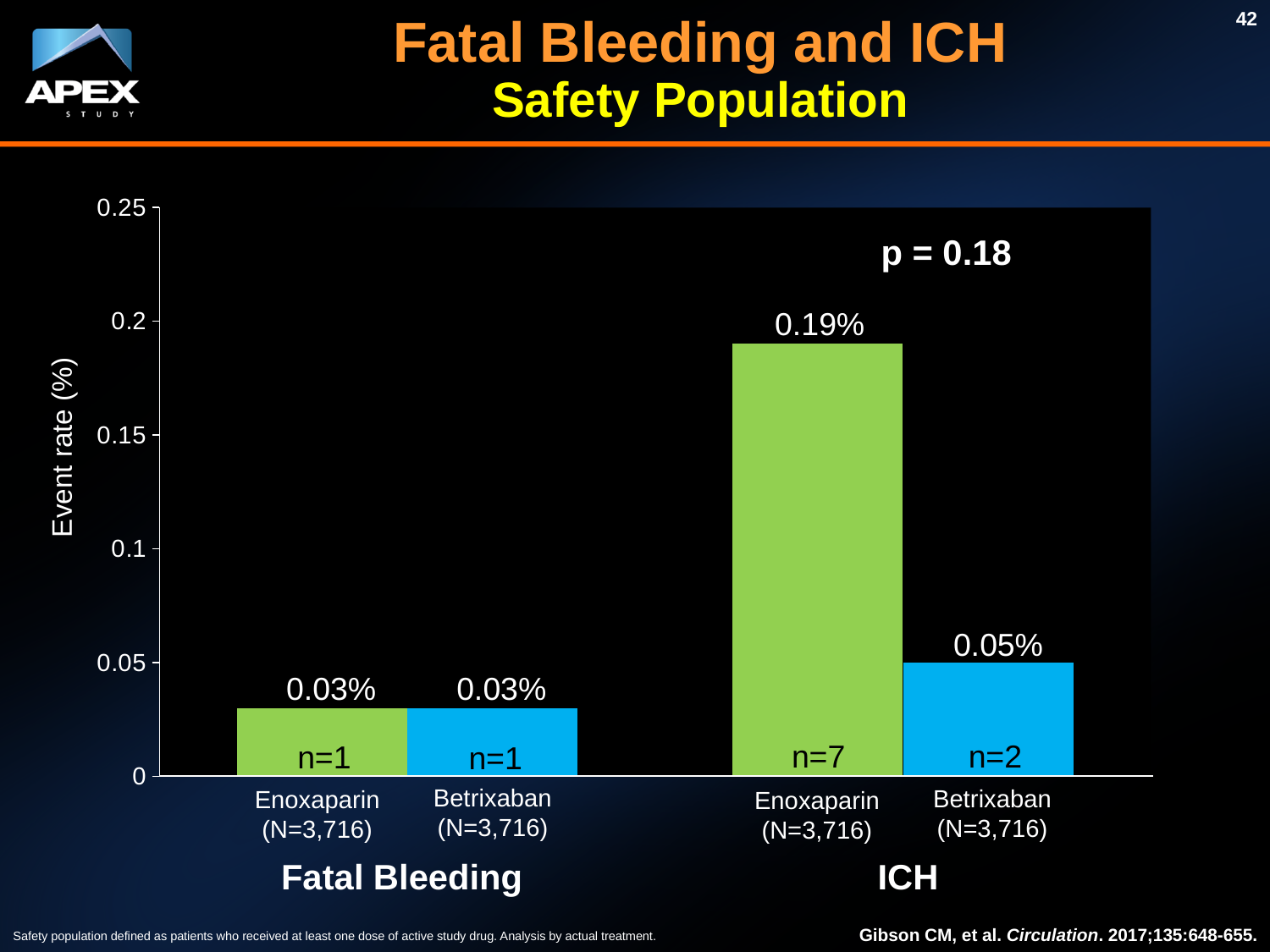
What p-value is shown on the chart for the ICH comparison? p = 0.18 How many bars are plotted on the chart? 4 What is the difference in event rate between Enoxaparin and Betrixaban in the ICH group? 0.14% What kind of chart is shown on the slide? Bar chart Is the event rate for Enoxaparin in the ICH group greater or less than 0.15? greater What is the event rate for Betrixaban in the ICH group? 0.05% Which bar has the highest event rate? Enoxaparin (ICH) What is the event rate for Enoxaparin in the ICH group? 0.19% In the ICH group, which has the larger event rate, Enoxaparin or Betrixaban? Enoxaparin How many events (n) are shown for Betrixaban in the ICH group? n=2 How many events (n) are shown for Enoxaparin in the ICH group? n=7 What is the event rate for Enoxaparin in the Fatal Bleeding group? 0.03%